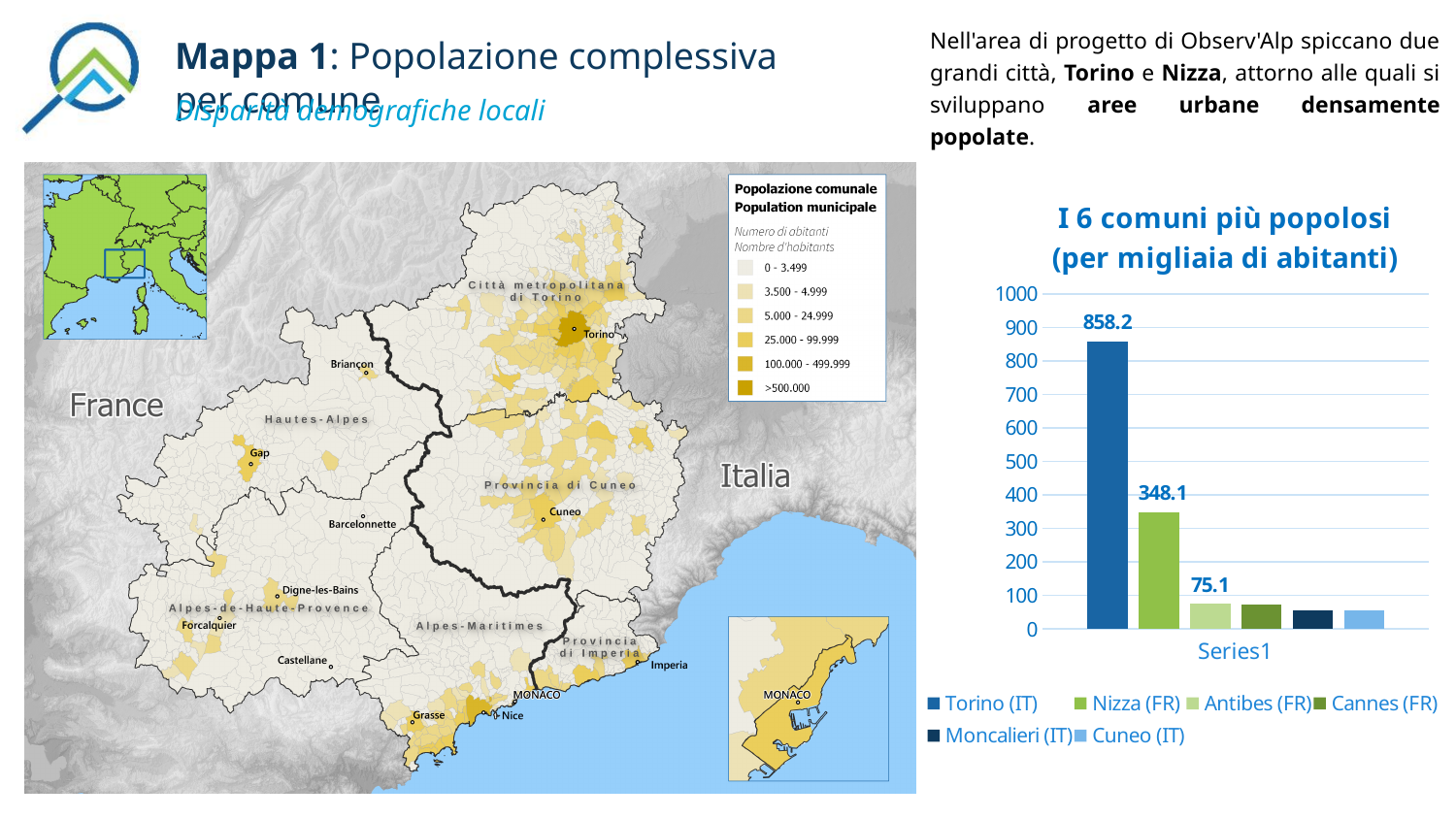
In the bar chart 'I 6 comuni più popolosi', what is the value for Antibes (FR)? 75.1 In the bar chart 'I 6 comuni più popolosi', is the value for Cannes (FR) greater or less than 100? less What unit does the title of the bar chart on the right say the values are in? migliaia di abitanti In the bar chart 'I 6 comuni più popolosi', is the value for Moncalieri (IT) greater or less than 100? less In the bar chart 'I 6 comuni più popolosi', what is the value for Nizza (FR)? 348.1 What kind of chart is 'I 6 comuni più popolosi'? bar chart In the bar chart 'I 6 comuni più popolosi', what is the value for Torino (IT)? 858.2 In the bar chart 'I 6 comuni più popolosi', what is the difference between the values for Nizza (FR) and Antibes (FR)? 273 In the bar chart 'I 6 comuni più popolosi', which comune has the highest value? Torino (IT) In the bar chart 'I 6 comuni più popolosi', which is larger, the value for Nizza (FR) or the value for Antibes (FR)? Nizza (FR) In the bar chart 'I 6 comuni più popolosi', what is the difference between the values for Torino (IT) and Nizza (FR)? 510.1 How many series does the legend of the bar chart 'I 6 comuni più popolosi' list? 6